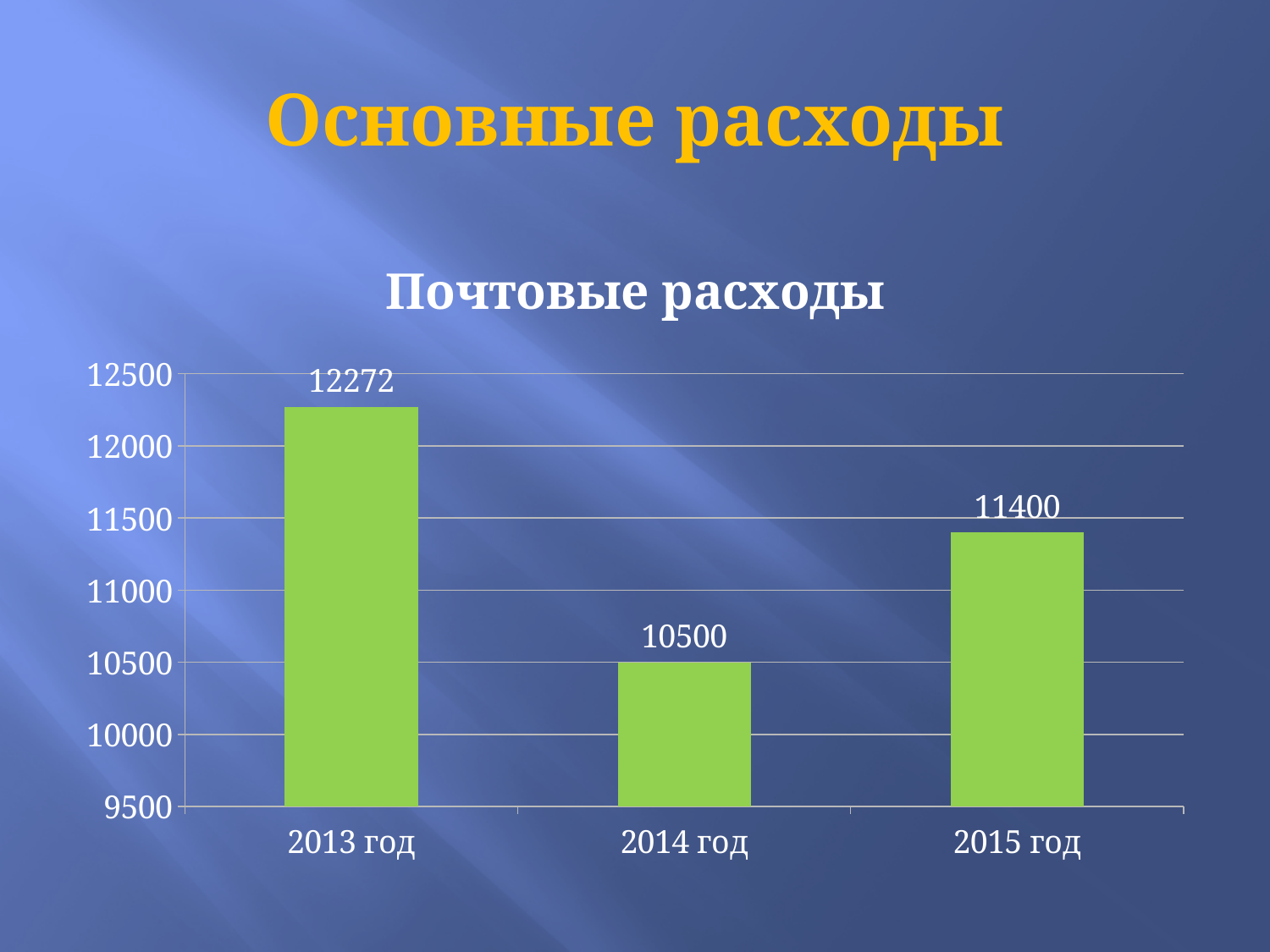
What is the difference between the values for 2015 год and 2014 год? 900 How many years are shown on the chart? 3 What kind of chart is shown on the slide? bar chart Which is larger, the value for 2015 год or the value for 2014 год? 2015 год Which year has the highest postal expenses? 2013 год What is the value for 2015 год? 11400 What is the title of the chart? Почтовые расходы What is the difference between the values for 2013 год and 2014 год? 1772 Is the value for 2013 год greater or less than 12000? greater Which year has the lowest postal expenses? 2014 год What is the value for 2013 год? 12272 What is the value for 2014 год? 10500